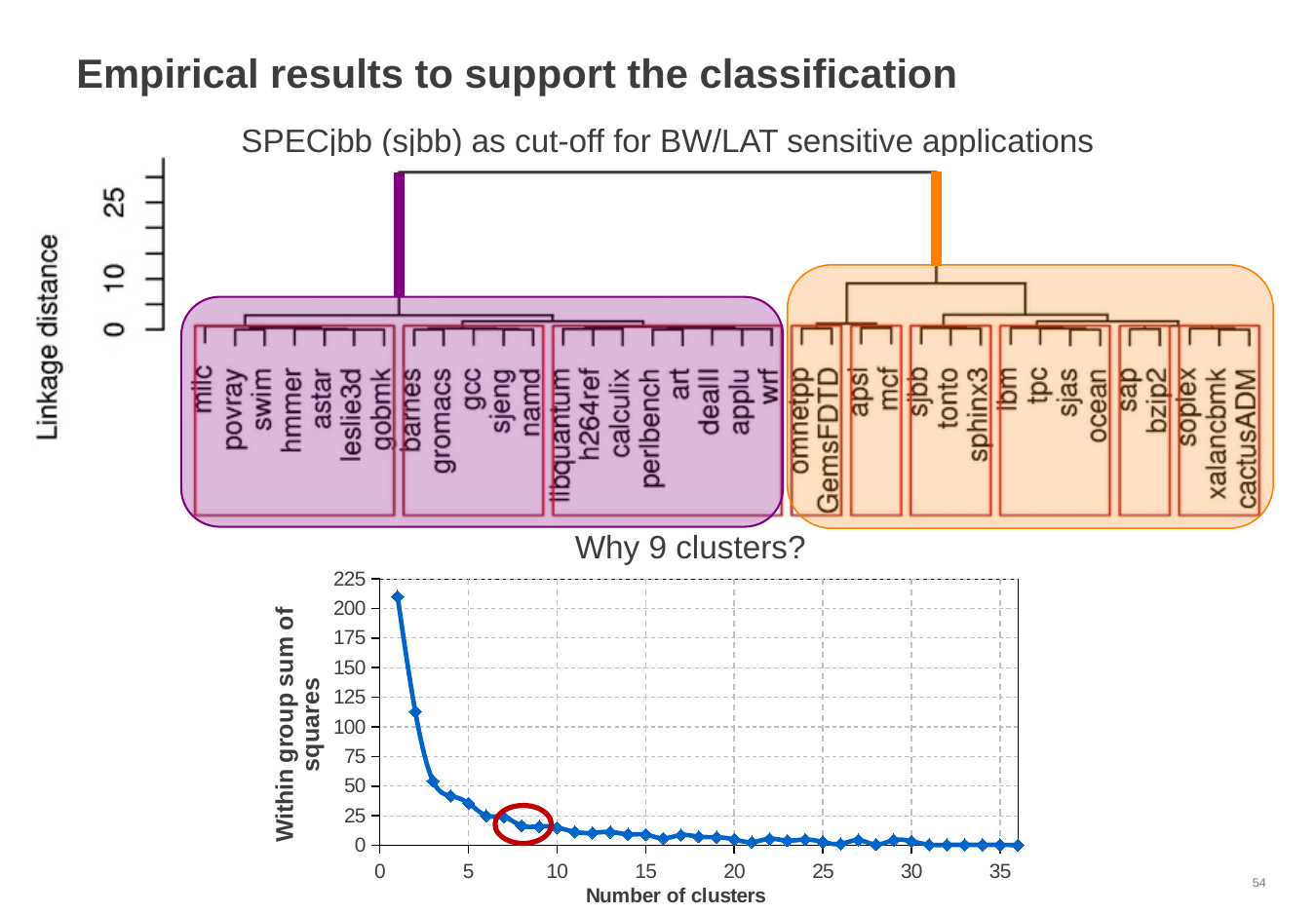
In the top dendrogram chart, how many applications are listed inside the orange (right) cluster? 16 In the bottom chart "Why 9 clusters?", what is the label of the x axis? Number of clusters In the top dendrogram chart, how many applications are listed inside the purple (left) cluster? 20 What kind of chart is the bottom chart titled "Why 9 clusters?"? line chart In the bottom chart "Why 9 clusters?", what is the label of the y axis? Within group sum of squares In the bottom chart "Why 9 clusters?", is the value for 3 clusters greater or less than 75? less In the bottom chart "Why 9 clusters?", what is the highest value shown on the y axis? 225 In the bottom chart "Why 9 clusters?", do the values rise or fall as the number of clusters increases? fall In the bottom chart "Why 9 clusters?", is the value for 10 clusters greater or less than 25? less In the bottom chart "Why 9 clusters?", is the value for 1 cluster greater or less than 200? greater In the bottom chart "Why 9 clusters?", which has the larger value: 1 cluster or 5 clusters? 1 cluster